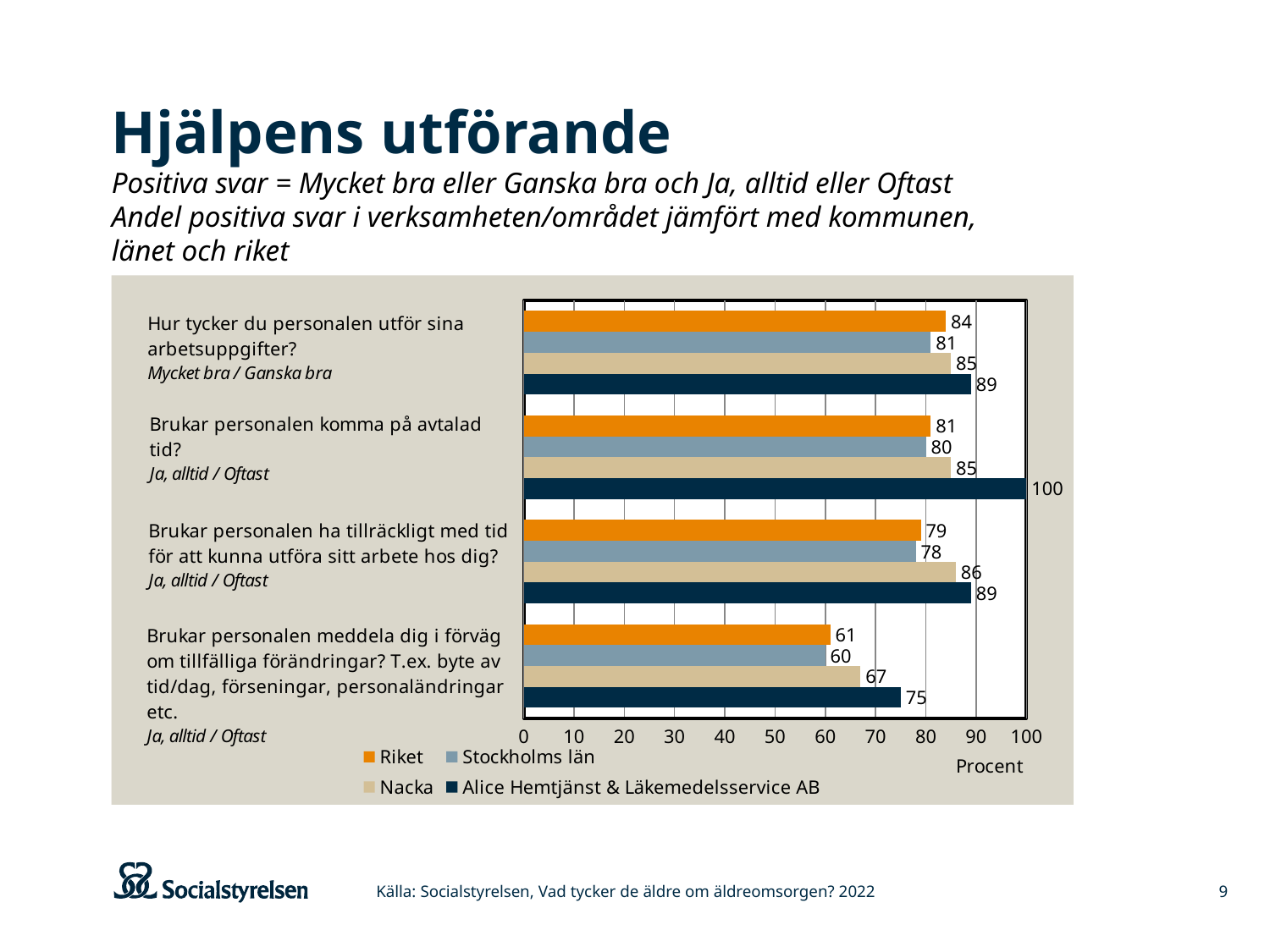
What is the value for Alice Hemtjänst & Läkemedelsservice AB for the question "Brukar personalen komma på avtalad tid?"? 100 What is the difference between the Nacka value and the Stockholms län value for the question "Brukar personalen komma på avtalad tid?"? 5 What is the difference between the Alice Hemtjänst & Läkemedelsservice AB value and the Riket value for the question "Brukar personalen meddela dig i förväg om tillfälliga förändringar?"? 14 What is the value for Nacka for the question "Brukar personalen ha tillräckligt med tid för att kunna utföra sitt arbete hos dig?"? 86 How many series does the legend list? 4 What is the value for Riket for the question "Hur tycker du personalen utför sina arbetsuppgifter?"? 84 What is the value for Stockholms län for the question "Brukar personalen meddela dig i förväg om tillfälliga förändringar?"? 60 Which series has the lowest value for the question "Brukar personalen meddela dig i förväg om tillfälliga förändringar?"? Stockholms län What kind of chart is shown on the slide? Bar chart How many questions (categories) are shown on the chart? 4 Which series has the highest value for the question "Brukar personalen komma på avtalad tid?"? Alice Hemtjänst & Läkemedelsservice AB For the question "Brukar personalen ha tillräckligt med tid för att kunna utföra sitt arbete hos dig?", which is larger: the Nacka value or the Riket value? Nacka